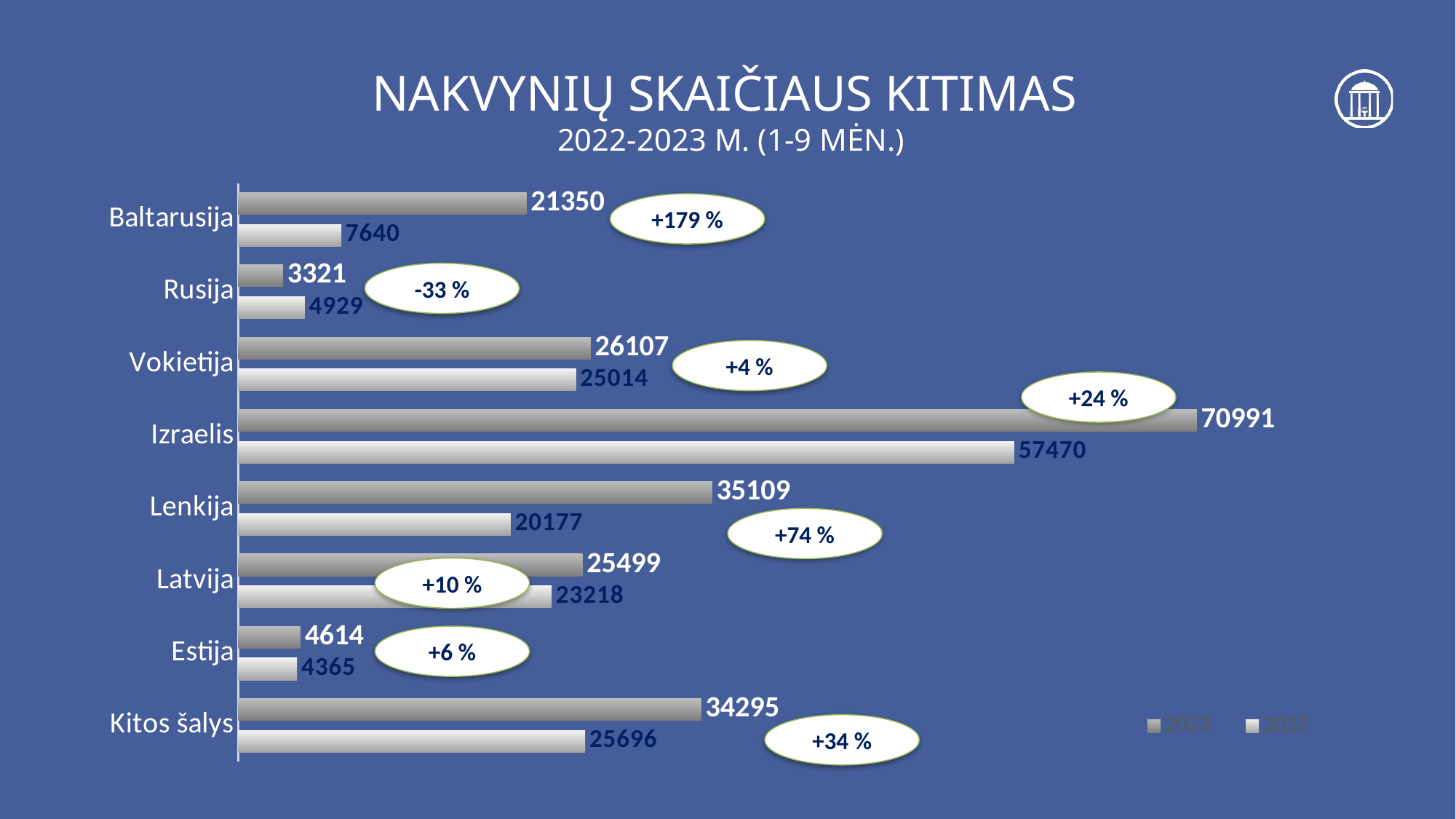
What percentage change is shown in the oval next to Lenkija? +74 % How many categories are shown on the chart? 8 What is the 2023 value for Rusija? 3321 What is the 2023 value for Izraelis? 70991 What is the difference between the 2023 and 2022 values for Baltarusija? 13710 What is the 2022 value for Lenkija? 20177 Which category has the highest 2023 value? Izraelis What kind of chart is shown on the slide? bar chart How many series does the legend list? 2 Which category has the lowest 2022 value? Estija What is the title of the chart? NAKVYNIŲ SKAIČIAUS KITIMAS 2022-2023 M. (1-9 MĖN.) Which is larger for Rusija, the 2023 value or the 2022 value? 2022